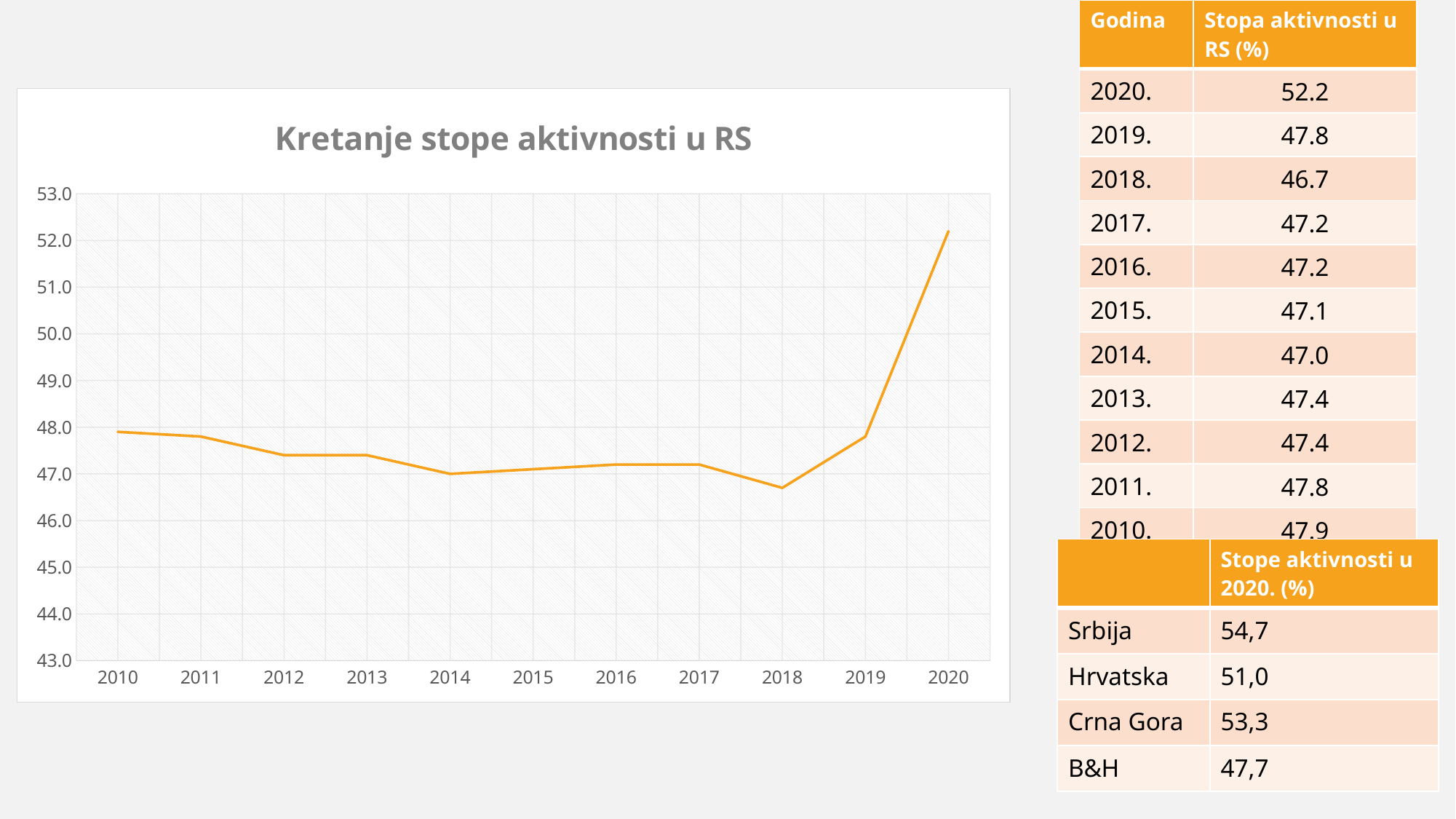
What kind of chart is shown on the slide? line chart How many years are plotted on the x axis of the chart? 11 Which is larger, the value for 2010 or the value for 2018? 2010 In which year does the chart reach its lowest value? 2018 What is the difference between the activity rate in 2020 and in 2019? 4.4 What is the activity rate in RS for 2018? 46.7 Does the line rise or fall between 2018 and 2020? rises What is the title of the chart? Kretanje stope aktivnosti u RS In which year does the chart reach its highest value? 2020 What is the activity rate in RS for 2020? 52.2 Is the value for 2014 greater or less than 48.0? less Is the value for 2020 greater or less than 50.0? greater